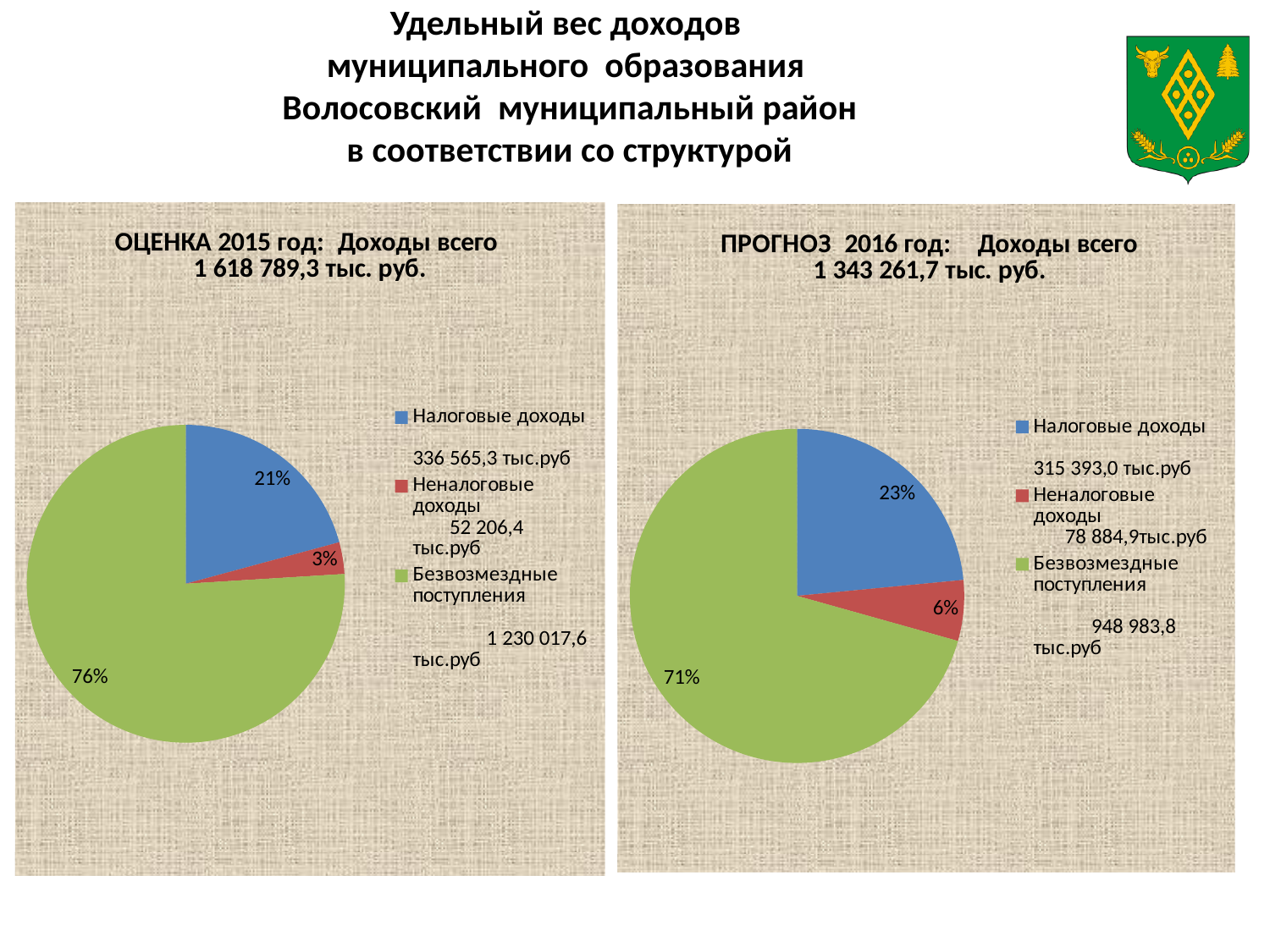
What kind of chart is used on the left (ОЦЕНКА 2015 год) side of the slide? pie chart In the ПРОГНОЗ 2016 год chart, what share of the pie is Неналоговые доходы? 6% In the ПРОГНОЗ 2016 год chart, what share of the pie is Налоговые доходы? 23% In the ПРОГНОЗ 2016 год chart, what is the value shown for Безвозмездные поступления in the legend? 948 983,8 тыс.руб In the ОЦЕНКА 2015 год chart, what share of the pie is Неналоговые доходы? 3% What total income (Доходы всего) is stated in the title of the ПРОГНОЗ 2016 год chart? 1 343 261,7 тыс. руб. In the ОЦЕНКА 2015 год chart, which category has the smallest slice? Неналоговые доходы In the ПРОГНОЗ 2016 год chart, which category has the largest slice? Безвозмездные поступления How many slices does the ПРОГНОЗ 2016 год pie chart have? 3 In the ОЦЕНКА 2015 год chart, what is the value shown for Налоговые доходы in the legend? 336 565,3 тыс.руб